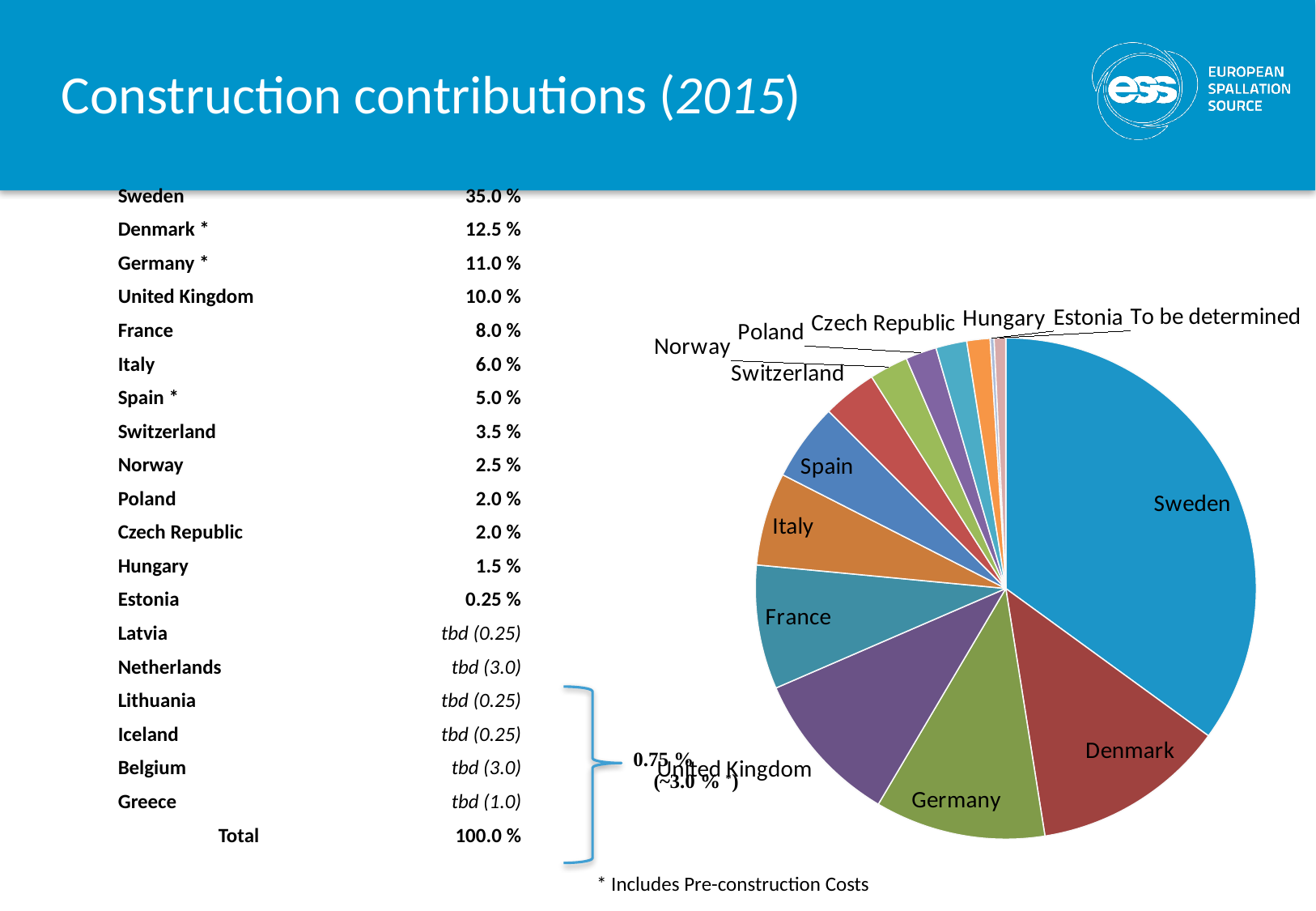
Which country has the largest slice in the pie chart? Sweden How many slices does the pie chart have? 14 What kind of chart is shown on the slide? pie chart Which slice is larger, Spain or Switzerland? Spain What is the title of the slide containing the pie chart? Construction contributions (2015) What is the difference between Sweden's and Denmark's contributions? 22.5 % What is Sweden's construction contribution share? 35.0 % What is the construction contribution of the United Kingdom? 10.0 % Which slice is larger, Denmark or Germany? Denmark Which country has the smallest slice in the pie chart? Estonia What does the asterisk footnote below the chart say? Includes Pre-construction Costs Which slice is larger, France or Italy? France